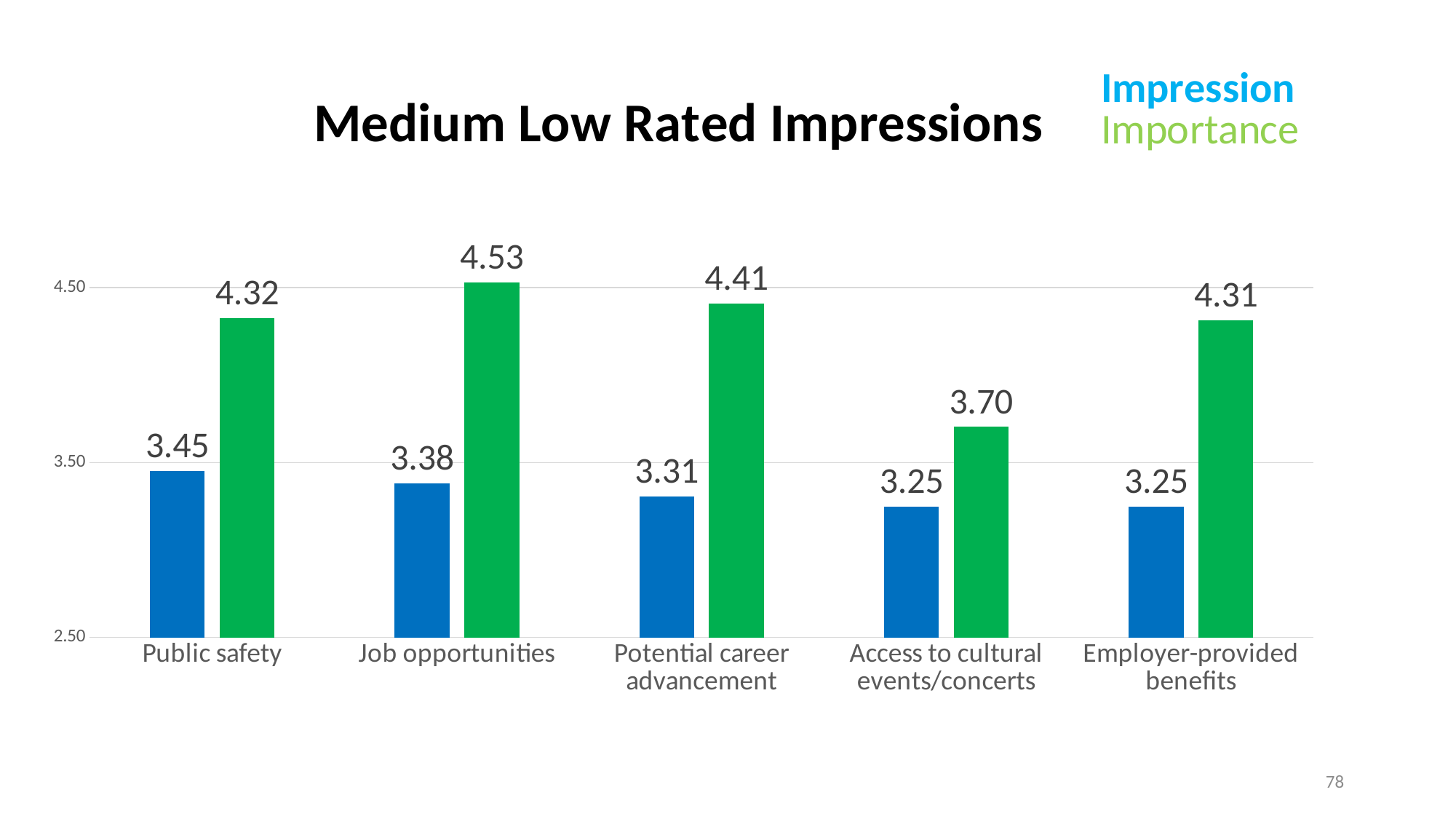
How many series does the legend list? 2 Which category has the highest Impression value? Public safety How many categories are shown on the x axis? 5 What is the difference between the Importance values for Job opportunities and Access to cultural events/concerts? 0.83 What is the difference between the Importance and Impression values for Potential career advancement? 1.10 Which category has the lowest Importance value? Access to cultural events/concerts What is the Impression value for Public safety? 3.45 Which category has the highest Importance value? Job opportunities Which is larger: the Impression value for Job opportunities or the Impression value for Employer-provided benefits? Job opportunities What is the Importance value for Job opportunities? 4.53 What kind of chart is shown on the slide? Bar chart What is the Importance value for Access to cultural events/concerts? 3.70